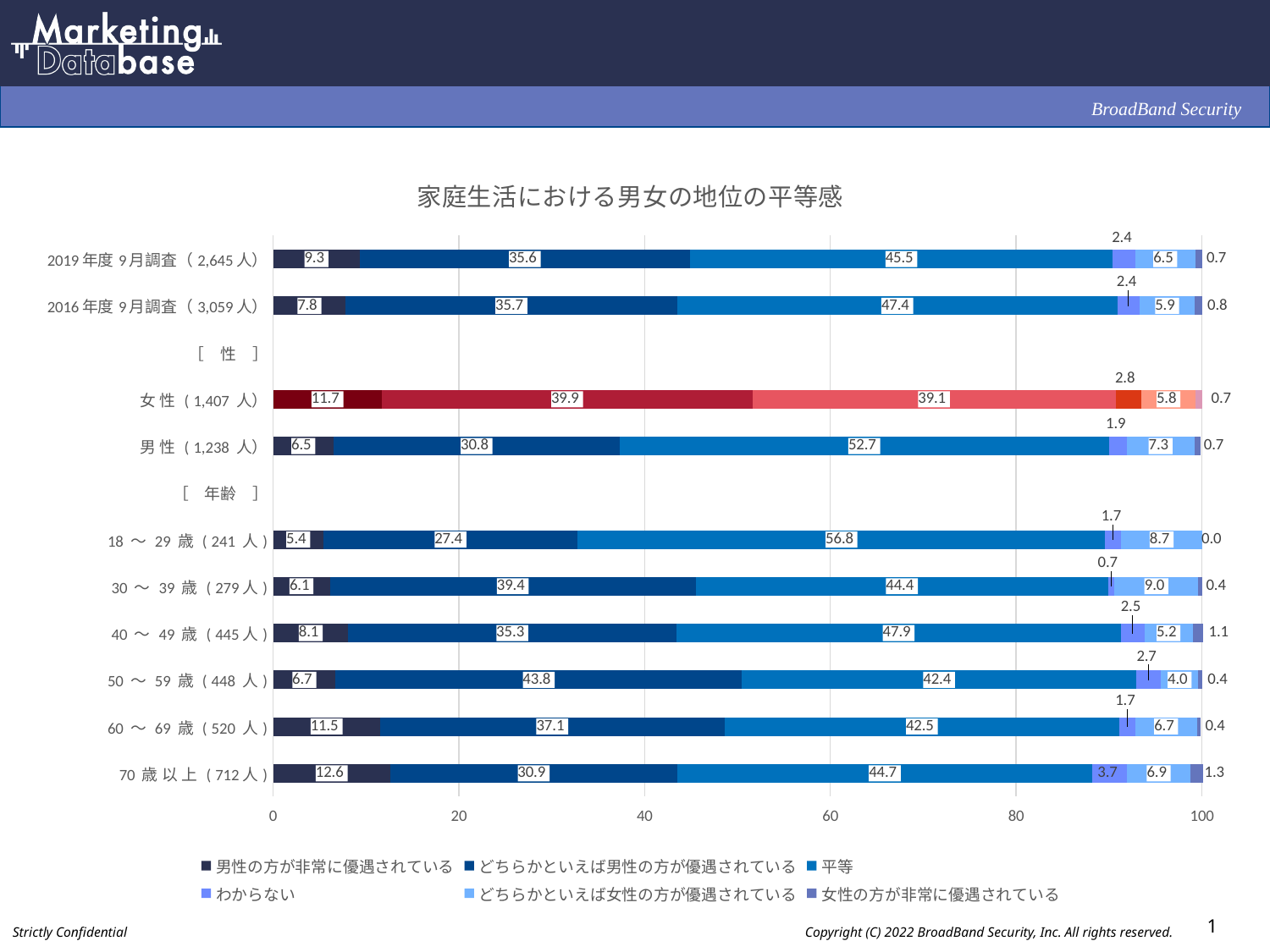
What is the value of どちらかといえば女性の方が優遇されている for 30 ～ 39 歳 (279人)? 9.0 What kind of chart is shown on the slide? Stacked bar chart What is the value of 平等 for 男性 (1,238 人)? 52.7 What is the value of わからない for 50 ～ 59 歳 (448 人)? 2.7 What is the value of 男性の方が非常に優遇されている for 70 歳以上 (712人)? 12.6 Which category has the lowest value for 男性の方が非常に優遇されている? 18 ～ 29 歳 (241 人) Which is larger: the どちらかといえば男性の方が優遇されている value for 女性 (1,407 人) or for 男性 (1,238 人)? 女性 (1,407 人) What is the difference between the 平等 values for 2016 年度 9月調査 (3,059 人) and 2019 年度 9月調査 (2,645 人)? 1.9 How many categories (bars) with data are plotted in the chart? 10 What is the title of the chart? 家庭生活における男女の地位の平等感 Which category has the highest value for 平等? 18 ～ 29 歳 (241 人) How many series does the legend list? 6